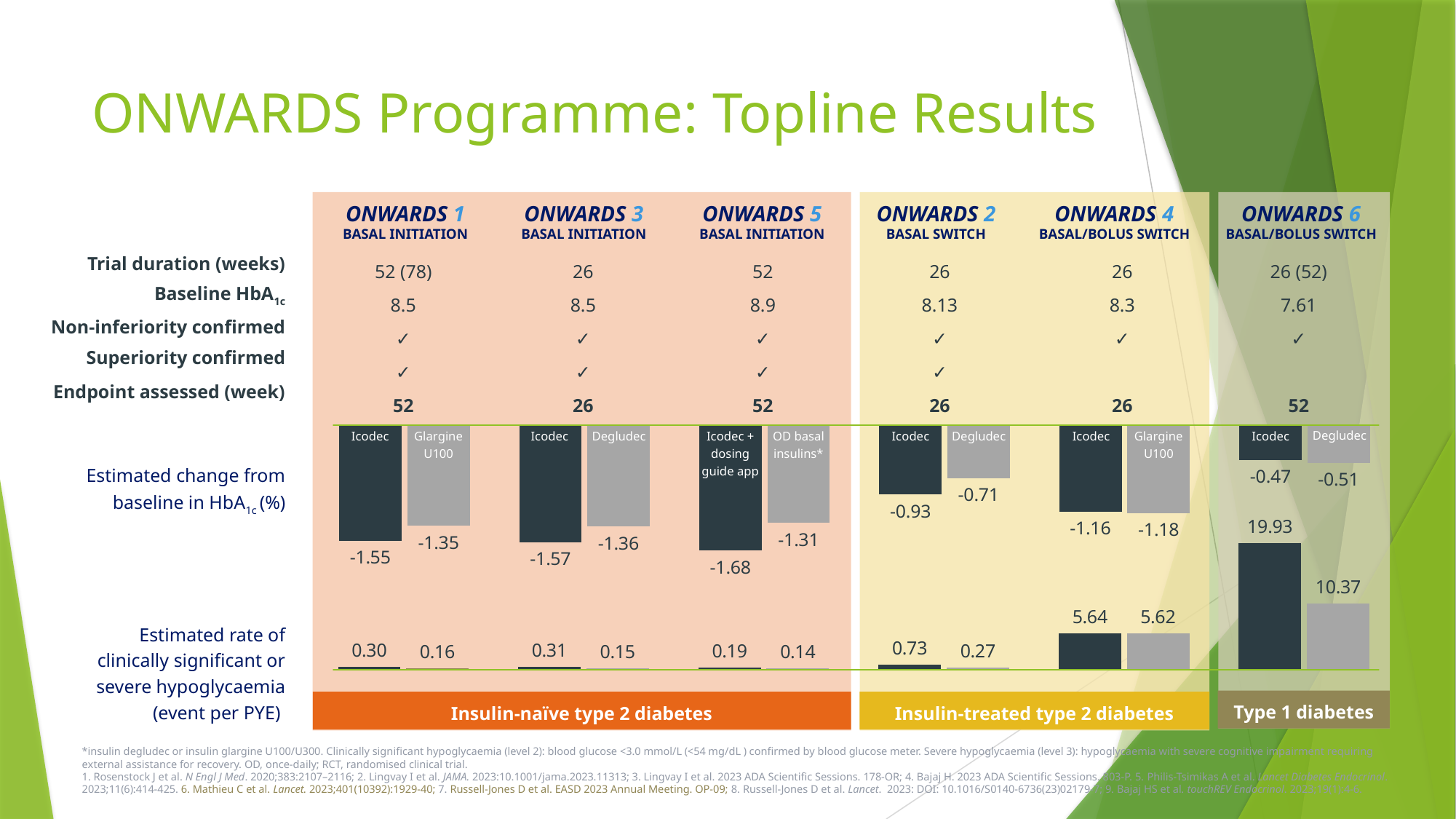
In the ONWARDS 6 chart of estimated rate of hypoglycaemia, what is the difference between the Icodec and Degludec values? 9.56 In the ONWARDS 1 chart of estimated rate of hypoglycaemia, which has the larger value, Icodec or Glargine U100? Icodec What kind of chart is used to show the estimated change from baseline in HbA1c for each trial? Bar chart In the ONWARDS 6 chart of estimated rate of clinically significant or severe hypoglycaemia, what is the value for Icodec? 19.93 In the ONWARDS 2 chart of estimated change from baseline in HbA1c, what is the difference between the Icodec and Degludec values? 0.22 How many bars are in the ONWARDS 5 chart of estimated change from baseline in HbA1c? 2 In the ONWARDS 3 chart of estimated change from baseline in HbA1c, what is the value for Degludec? -1.36 In the ONWARDS 2 chart of estimated rate of clinically significant or severe hypoglycaemia, what is the value for Degludec? 0.27 In the ONWARDS 1 chart of estimated change from baseline in HbA1c, what is the value for Icodec? -1.55 In the ONWARDS 4 chart of estimated rate of hypoglycaemia, what is the difference between the Icodec and Glargine U100 values? 0.02 Across all six trials, which trial's hypoglycaemia rate chart shows the highest value? ONWARDS 6 In the ONWARDS 5 chart of estimated change from baseline in HbA1c, what is the value for Icodec + dosing guide app? -1.68